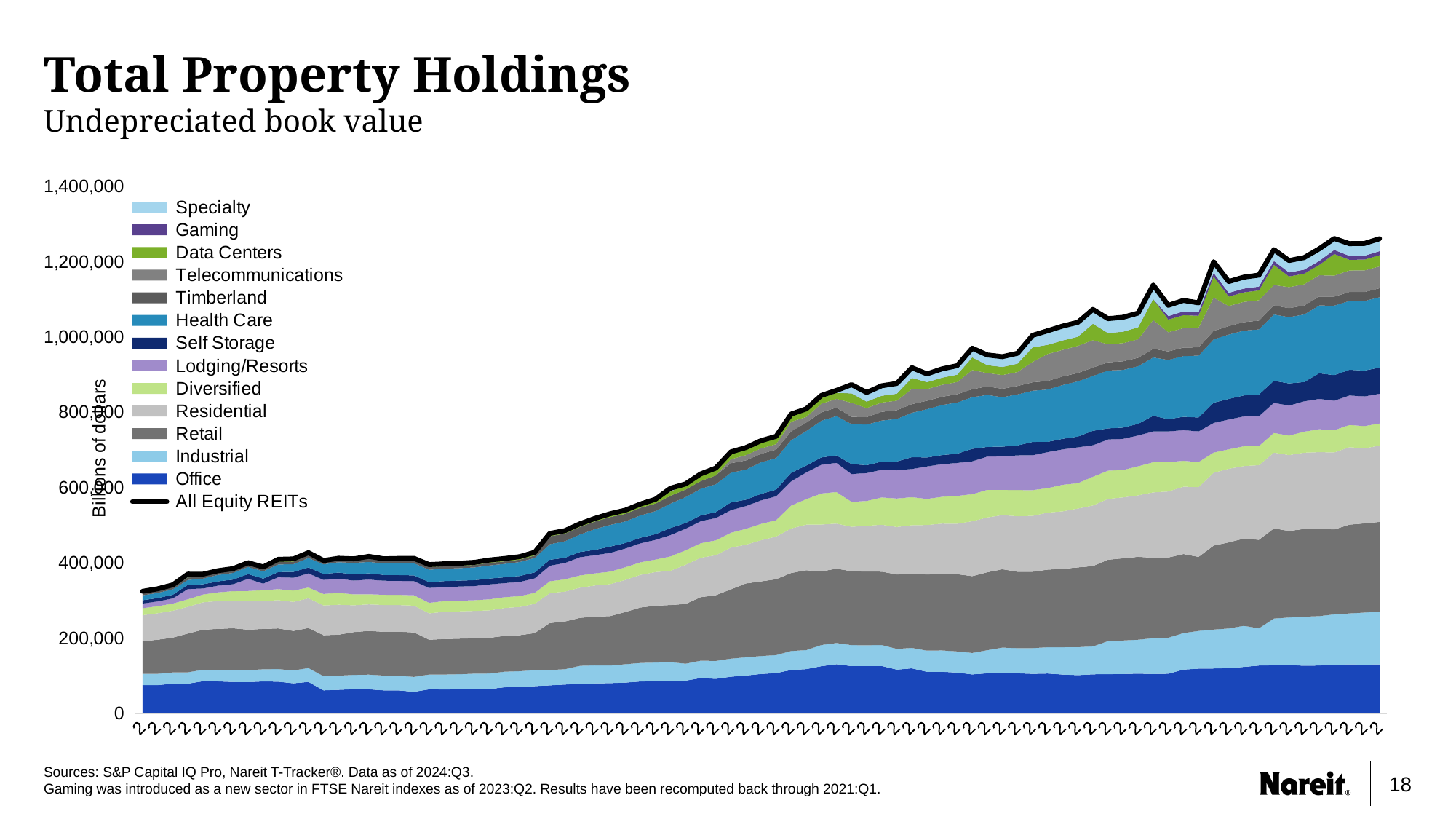
Which legend entry is drawn as a line rather than a shaded area? All Equity REITs Does the All Equity REITs line generally rise or fall from left to right across the chart? Rise What kind of chart is shown on the slide? Stacked area chart with a line overlay Does the All Equity REITs line ever reach a value greater or less than 1,400,000? less At the right end of the chart, which area is thicker: Retail or Office? Retail Is the All Equity REITs value at the left end of the chart greater or less than 400,000? less Which series forms the bottom layer of the stacked areas? Office At the right end of the chart, which area is thicker: Health Care or Gaming? Health Care Is the All Equity REITs value at the right end of the chart greater or less than 1,200,000? greater How many entries does the chart legend list? 14 What is the label on the vertical axis of the chart? Billions of dollars